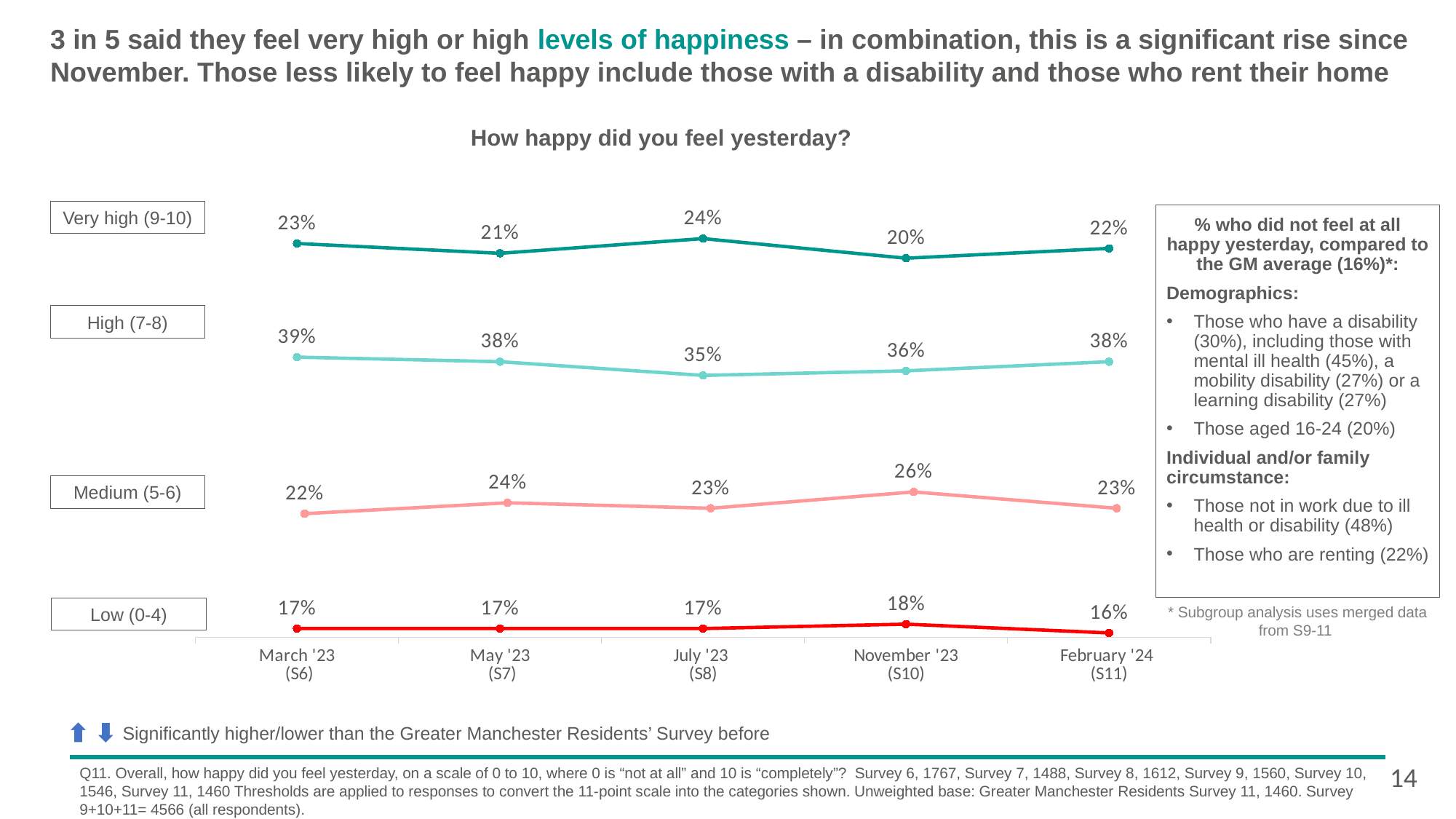
In which survey wave is the Very high (9-10) value highest? July '23 (S8) What is the value for Low (0-4) in February '24 (S11)? 16% What is the value for Medium (5-6) in July '23 (S8)? 23% How many survey waves are plotted along the x axis? 5 What is the title of the chart? How happy did you feel yesterday? What type of chart is shown on the slide? Line chart How many series (happiness categories) are plotted on the chart? 4 What is the value for Very high (9-10) in November '23 (S10)? 20% Which is larger in November '23 (S10): the Medium (5-6) value or the Very high (9-10) value? Medium (5-6) What is the value for High (7-8) in March '23 (S6)? 39% What is the difference between the High (7-8) value in March '23 (S6) and in July '23 (S8)? 4% In which survey wave is the High (7-8) value lowest? July '23 (S8)